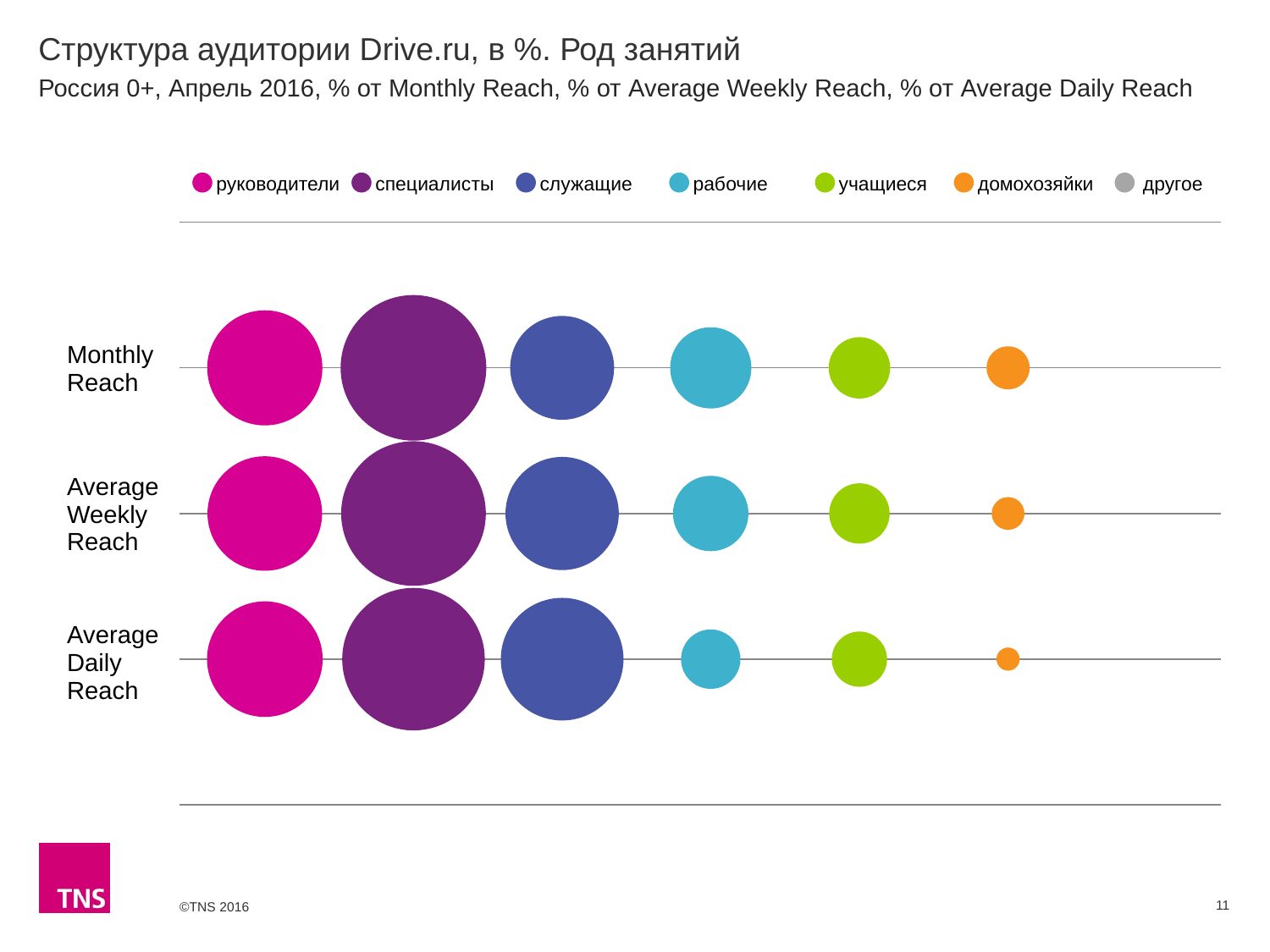
How many series does the legend list? 7 In the Average Daily Reach row, which bubble is larger: служащие or учащиеся? служащие Which occupation group has the smallest visible bubble in the Average Daily Reach row? домохозяйки In the Monthly Reach row, which bubble is larger: руководители or рабочие? руководители Does the служащие bubble get larger or smaller going from Monthly Reach to Average Daily Reach? larger How many reach categories (rows) are plotted on the chart? 3 Which occupation group has the largest bubble in the Average Weekly Reach row? специалисты What colour is the bubble for специалисты? purple Does the домохозяйки bubble get larger or smaller going from Monthly Reach to Average Daily Reach? smaller Which occupation group has the largest bubble in the Monthly Reach row? специалисты What kind of chart is shown on the slide? bubble chart Which legend entry is listed last? другое